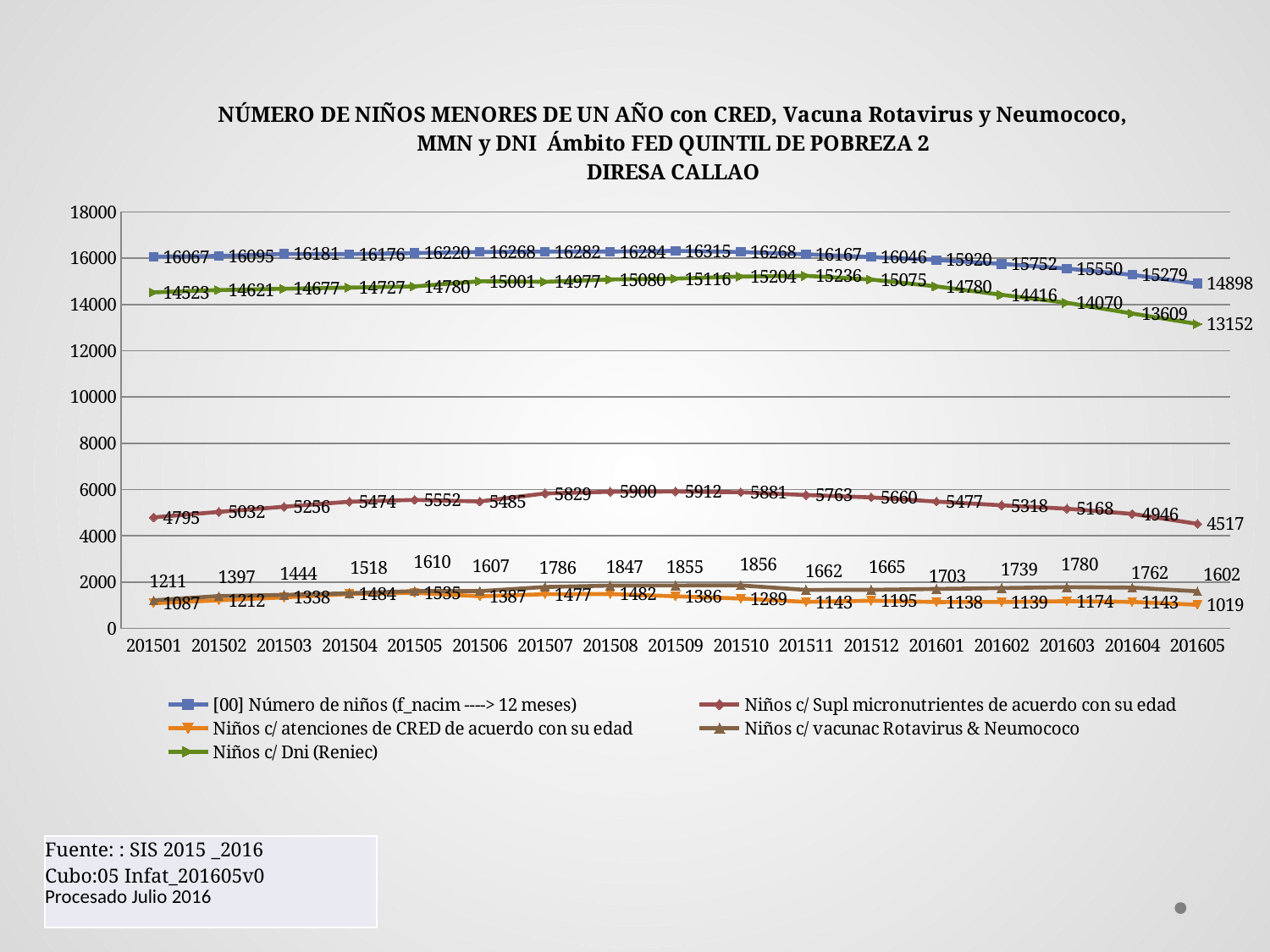
Is the value of 'Niños c/ Dni (Reniec)' at 201605 greater or less than 14000? less In which period does 'Niños c/ Supl micronutrientes de acuerdo con su edad' reach its highest value? 201509 What is the value of 'Niños c/ vacunac Rotavirus & Neumococo' at 201508? 1847 Does the 'Niños c/ Dni (Reniec)' series rise or fall from 201511 to 201605? fall In which period is 'Niños c/ atenciones de CRED de acuerdo con su edad' at its lowest value? 201605 How many series does the legend list? 5 What kind of chart is shown on the slide? line chart At 201510, which is larger: 'Niños c/ vacunac Rotavirus & Neumococo' or 'Niños c/ atenciones de CRED de acuerdo con su edad'? Niños c/ vacunac Rotavirus & Neumococo What is the value of 'Niños c/ Dni (Reniec)' at 201511? 15236 What is the difference between the '[00] Número de niños' values at 201501 and 201605? 1169 How many periods are shown on the x axis? 17 What is the value of the series '[00] Número de niños (f_nacim ----> 12 meses)' at 201605? 14898